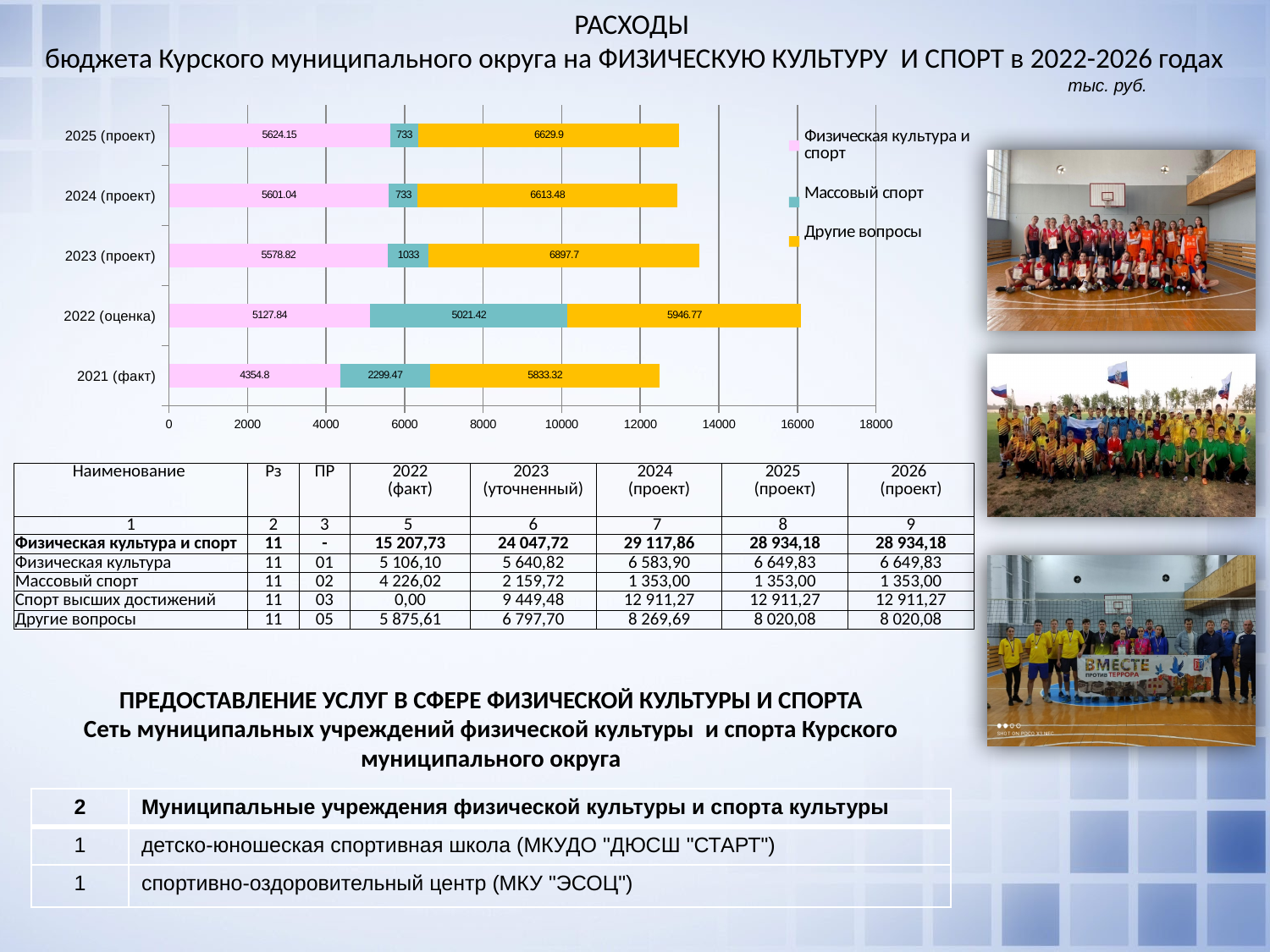
Which year has the lowest value for Физическая культура и спорт in the chart? 2021 (факт) How many series does the chart legend list? 3 What is the value of Физическая культура и спорт for 2025 (проект) in the chart? 5624.15 What type of chart is shown on the slide? stacked bar chart What is the total of the stacked bar for 2022 (оценка)? 16096.03 Which is larger: Другие вопросы for 2023 (проект) or Другие вопросы for 2024 (проект)? 2023 (проект) What is the difference between the Массовый спорт values for 2022 (оценка) and 2021 (факт)? 2721.95 Which year has the highest value for Другие вопросы in the chart? 2023 (проект) What is the value of Массовый спорт for 2022 (оценка) in the chart? 5021.42 How many year categories are plotted in the chart? 5 What is the value of Другие вопросы for 2021 (факт) in the chart? 5833.32 Which year has the highest value for Массовый спорт in the chart? 2022 (оценка)